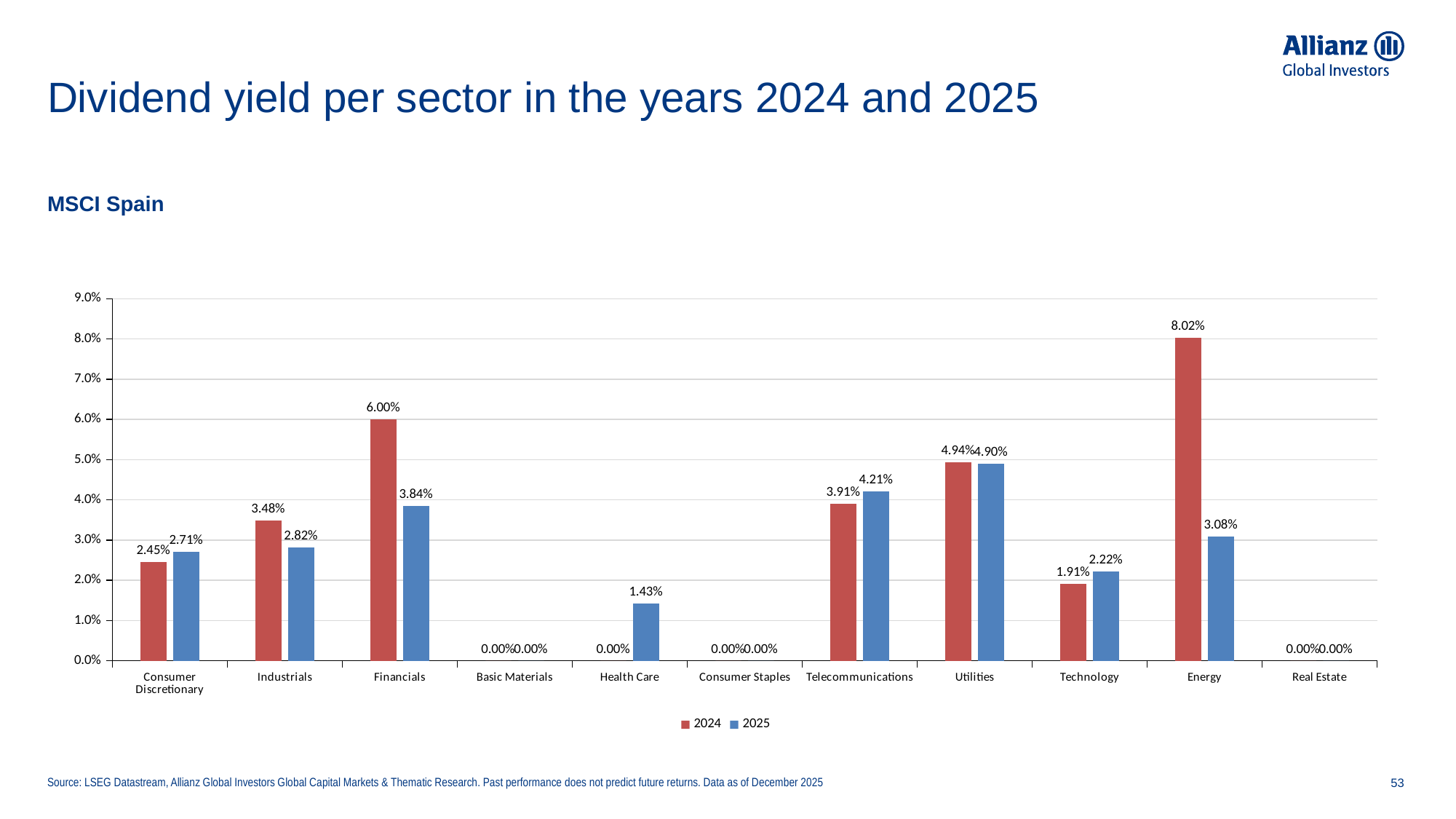
What is the difference between the 2024 and 2025 dividend yields for Financials? 2.16% Is the 2024 dividend yield for Financials greater or less than 5.0%? greater What kind of chart is shown on the slide? Bar chart Which index does the chart cover, according to the subtitle? MSCI Spain Which sector has the highest 2025 dividend yield? Utilities Which is larger for Technology, the 2024 or the 2025 dividend yield? 2025 How many sectors are shown on the x axis? 11 What is the 2025 dividend yield for Telecommunications? 4.21% What is the 2025 dividend yield for Health Care? 1.43% What is the 2024 dividend yield for Energy? 8.02% How many series does the legend list? 2 Which sector has the highest 2024 dividend yield? Energy